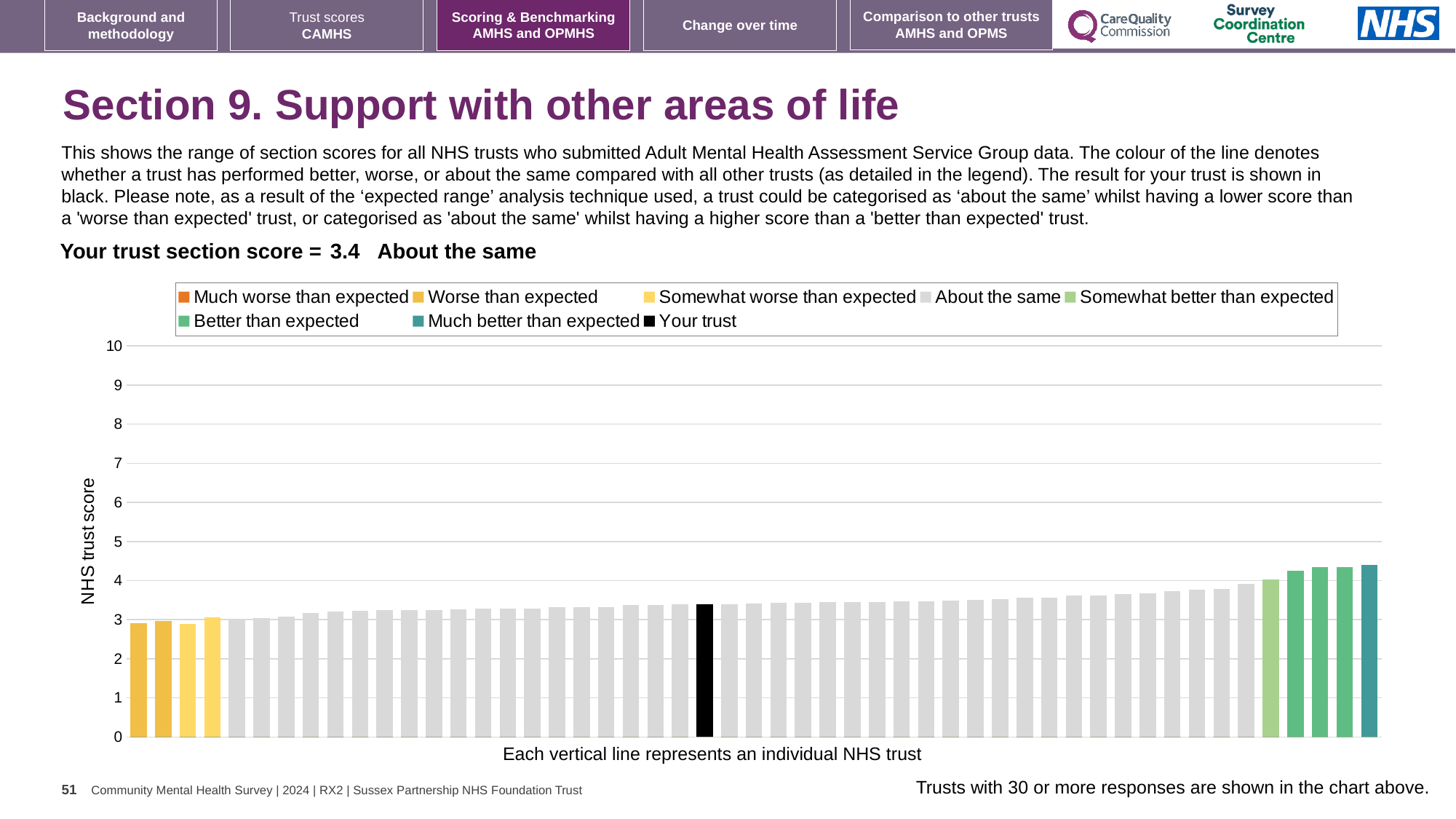
Is the value for your trust (the black bar) greater or less than 3? greater Which legend category does your trust's score fall into? About the same How many entries does the chart legend list? 8 Do the bar values rise or fall from left to right across the chart? rise How many bars are coloured as 'Better than expected' (green)? 3 What kind of chart is shown on the slide? bar chart Which legend category does the tallest bar belong to? Much better than expected Is the value for your trust (the black bar) greater or less than 4? less Is the tallest bar in the chart greater or less than 5? less What is the section score for your trust shown on the slide? 3.4 What is the label on the vertical axis of the chart? NHS trust score